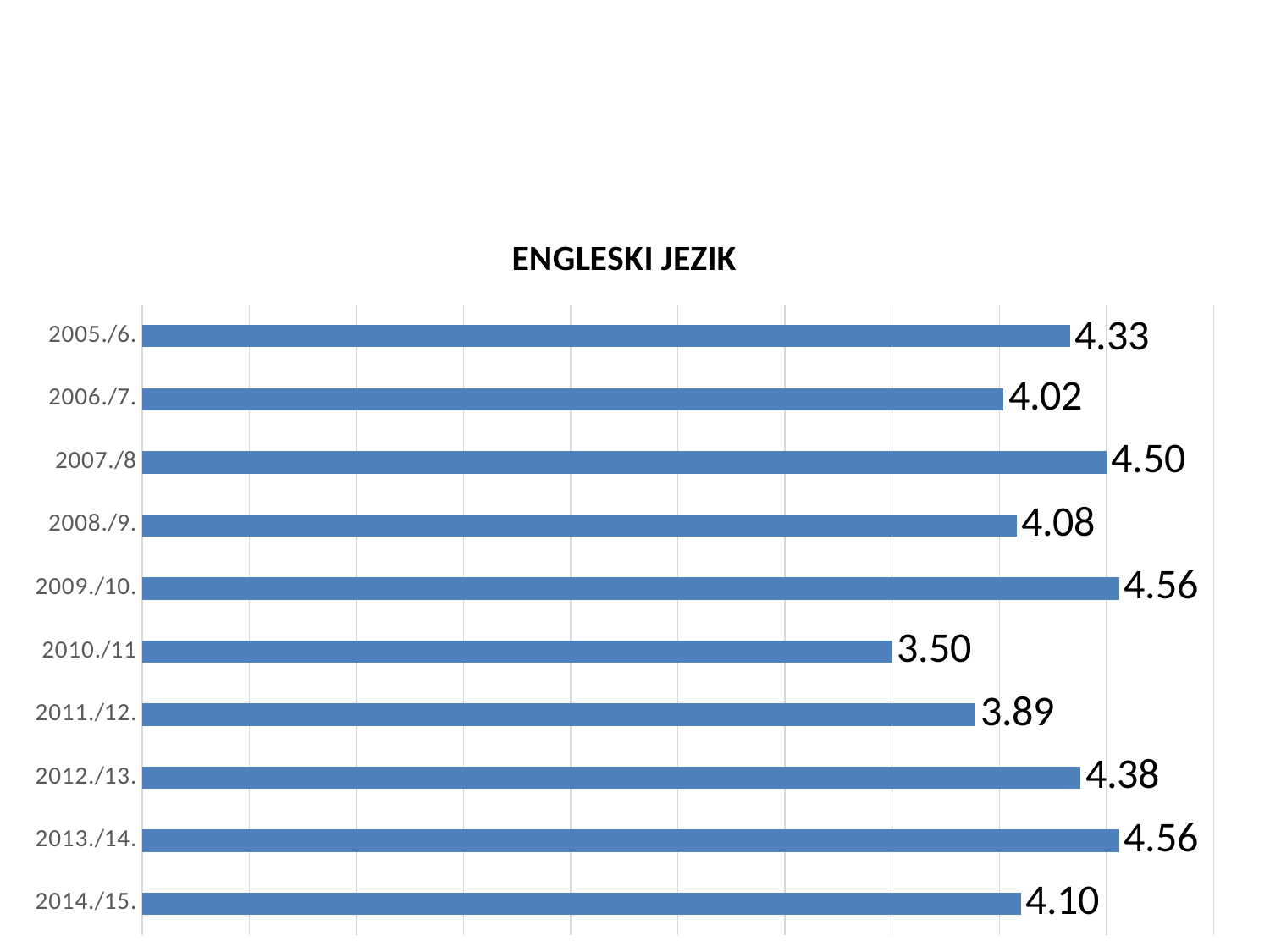
How many school years are shown in the chart? 10 What is the difference between the values for 2013./14. and 2014./15.? 0.46 What is the title of the chart? ENGLESKI JEZIK What is the value for 2012./13.? 4.38 What kind of chart is shown on the slide? Bar chart What is the value for 2010./11? 3.50 Which is larger, the value for 2008./9. or the value for 2011./12.? 2008./9. What is the value for 2005./6.? 4.33 What is the value for 2014./15.? 4.10 Which school year has the lowest value? 2010./11 Which is larger, the value for 2009./10. or the value for 2010./11? 2009./10. What is the difference between the values for 2007./8 and 2006./7.? 0.48